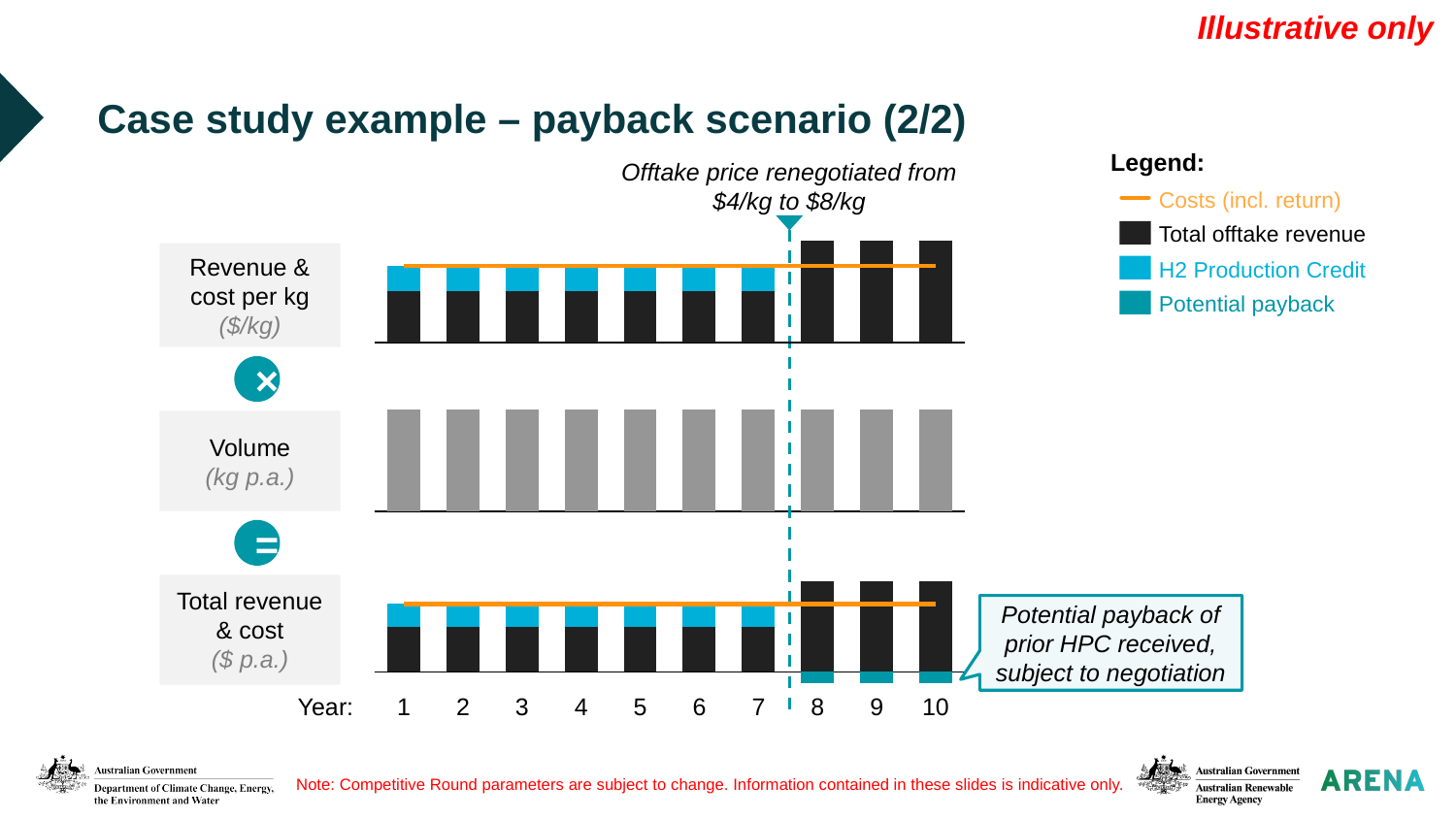
In the Total revenue & cost chart, do the Total offtake revenue bars in years 8 to 10 rise above or stay below the orange Costs line? Rise above How many years are shown along the x axis of the charts? 10 Between which two years does the dashed vertical line marking the offtake price renegotiation fall? Between year 7 and year 8 In the Revenue & cost per kg chart, which years include an H2 Production Credit segment? Years 1 to 7 According to the annotation, the offtake price is renegotiated from what price to what price? $4/kg to $8/kg In the Volume (kg p.a.) chart, do the bars rise, fall or stay flat from year 1 to year 10? Stay flat How many entries does the legend list? 4 What units are given for the Total revenue & cost chart? $ p.a. In the Total revenue & cost chart, which years show a Potential payback segment below the axis? Years 8, 9 and 10 In the Revenue & cost per kg chart, which year has the taller Total offtake revenue bar, year 7 or year 8? Year 8 What colour is used for Costs (incl. return) in the legend? Orange What kind of chart is used for the Volume (kg p.a.) panel? Bar chart